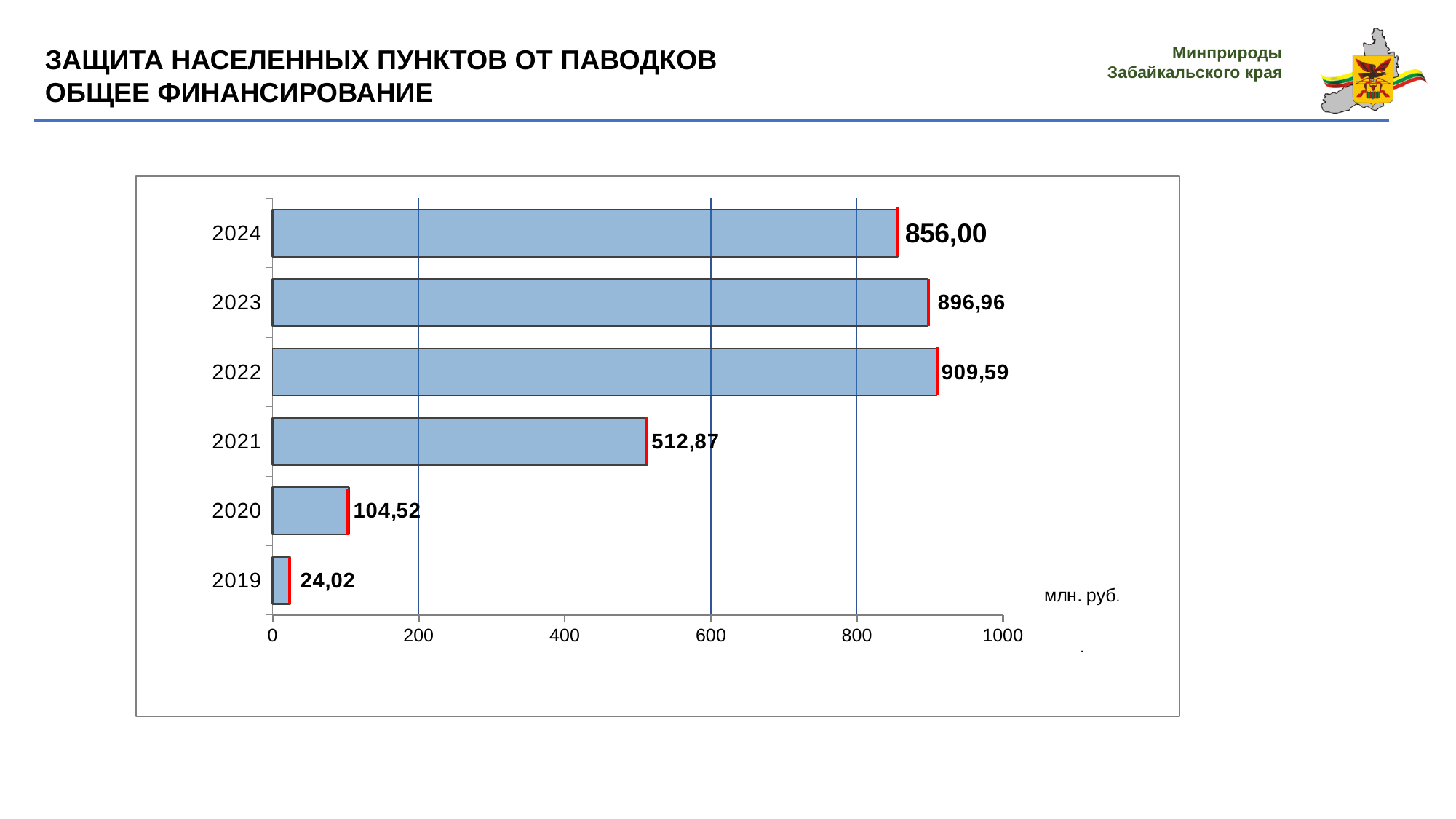
What is the value for 2024? 856,00 What is the value for 2019? 24,02 What is the difference between the values for 2021 and 2020? 408,35 What kind of chart is shown on the slide? bar chart What is the value for 2021? 512,87 Is the value for 2021 greater or less than 400? greater Which year has the highest value? 2022 Which is larger, the value for 2023 or the value for 2024? 2023 How many years are shown on the chart? 6 Which year has the lowest value? 2019 What unit is indicated for the values on the chart? млн. руб. What is the difference between the values for 2022 and 2023? 12,63